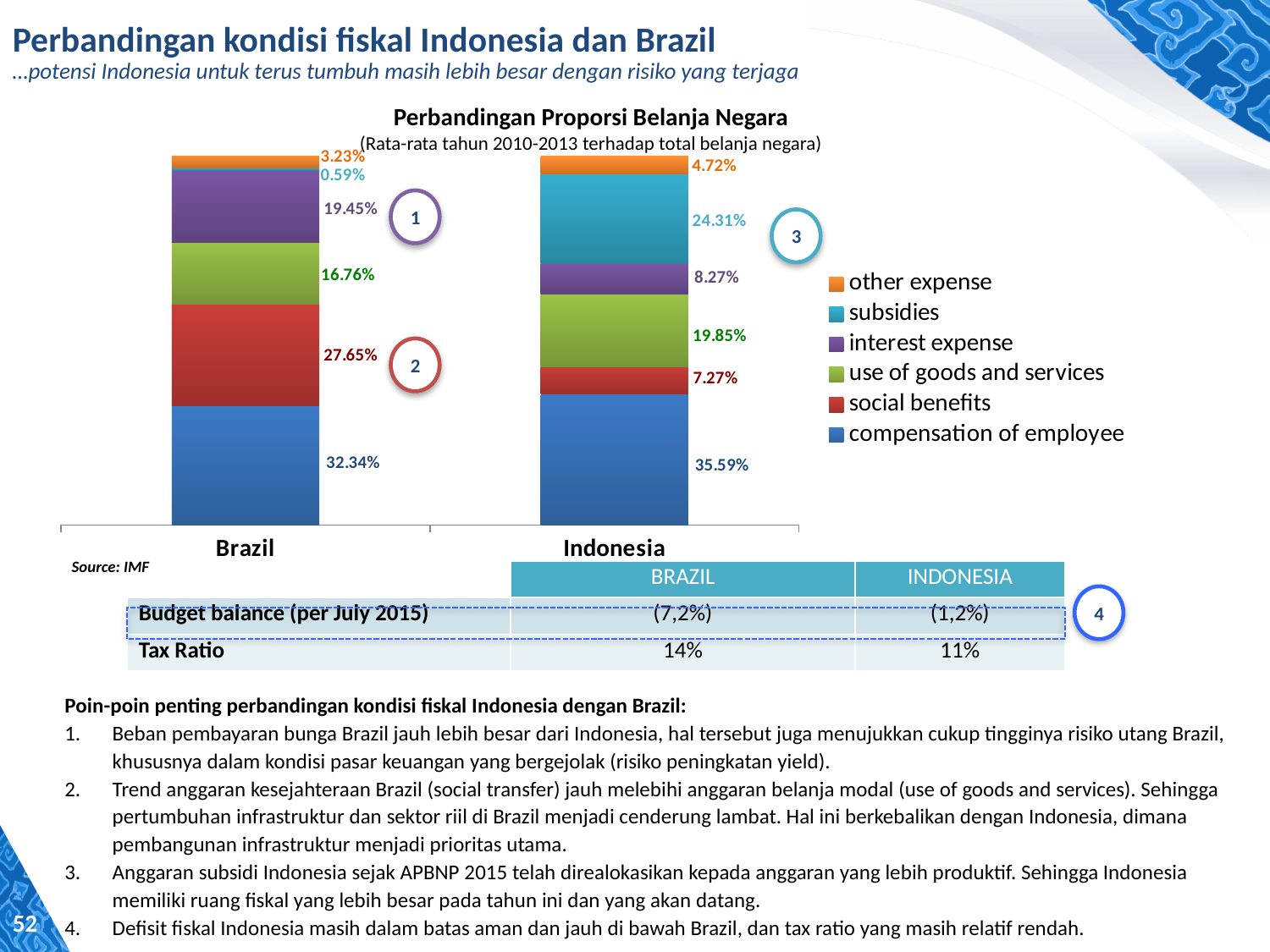
What is the value for compensation of employee for Indonesia? 35.59% Which series has the smallest share in the Brazil bar? subsidies What is the value for subsidies for Indonesia? 24.31% Which series has the largest share in the Brazil bar? compensation of employee What is the difference between the social benefits values for Brazil and Indonesia? 20.38% What is the title of the chart? Perbandingan Proporsi Belanja Negara Which country has the larger value for use of goods and services? Indonesia How many series does the legend list? 6 What is the value for interest expense for Brazil? 19.45% What type of chart is shown on the slide? Stacked bar chart What is the value for social benefits for Brazil? 27.65% How many countries are compared on the x axis of the chart? 2